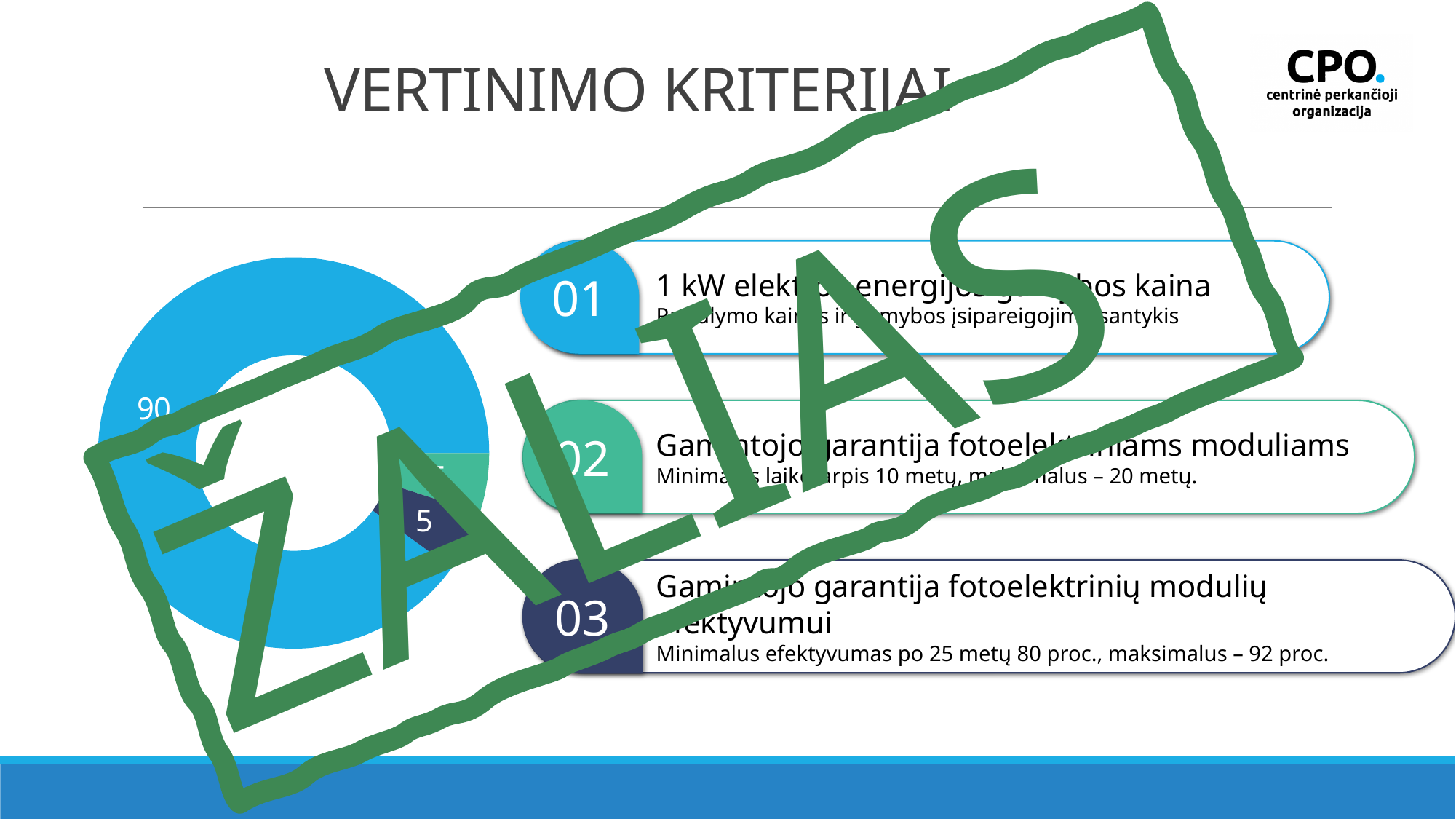
What is the difference between the blue slice value and the dark navy slice value in the doughnut chart? 85 What is the title of the slide containing the doughnut chart? VERTINIMO KRITERIJAI What colour is the largest slice of the doughnut chart? blue What value is labelled on the dark navy slice of the doughnut chart? 5 What is the largest value shown in the doughnut chart? 90 Which slice of the doughnut chart is larger, the blue one or the dark navy one? the blue one What value is labelled on the large blue slice of the doughnut chart? 90 What kind of chart is shown on the left of the slide? doughnut chart How many slices does the doughnut chart have? 3